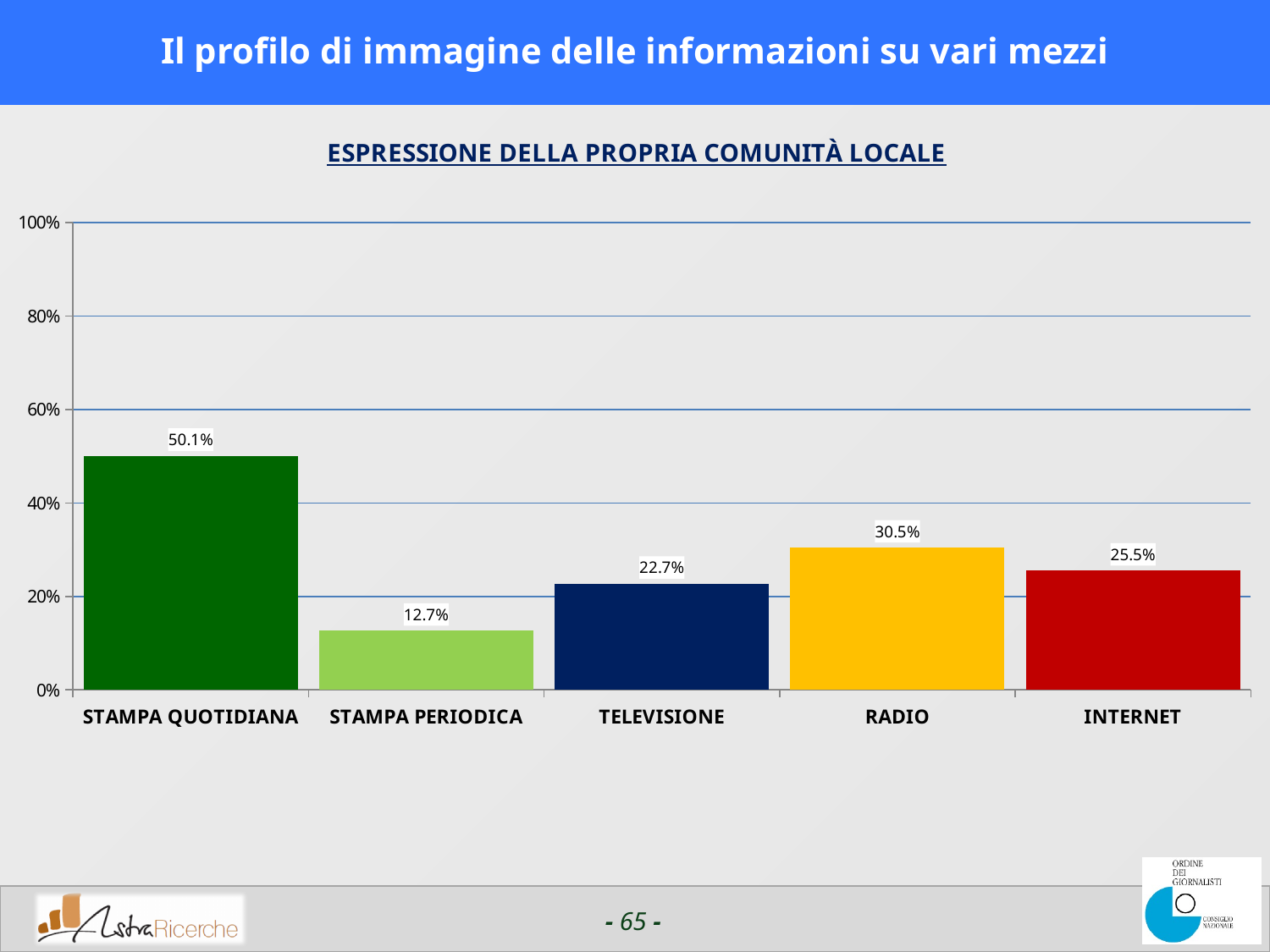
What is the value for STAMPA QUOTIDIANA? 50.1% What is the title shown above the chart? ESPRESSIONE DELLA PROPRIA COMUNITÀ LOCALE Which is larger, the value for RADIO or the value for INTERNET? RADIO What is the difference between the values for STAMPA QUOTIDIANA and STAMPA PERIODICA? 37.4% How many categories are shown on the x axis? 5 Which category has the lowest value? STAMPA PERIODICA Which category has the highest value? STAMPA QUOTIDIANA What is the value for INTERNET? 25.5% Is the value for TELEVISIONE greater or less than 20%? greater What is the difference between the values for RADIO and TELEVISIONE? 7.8% What kind of chart is shown on the slide? bar chart What is the value for RADIO? 30.5%